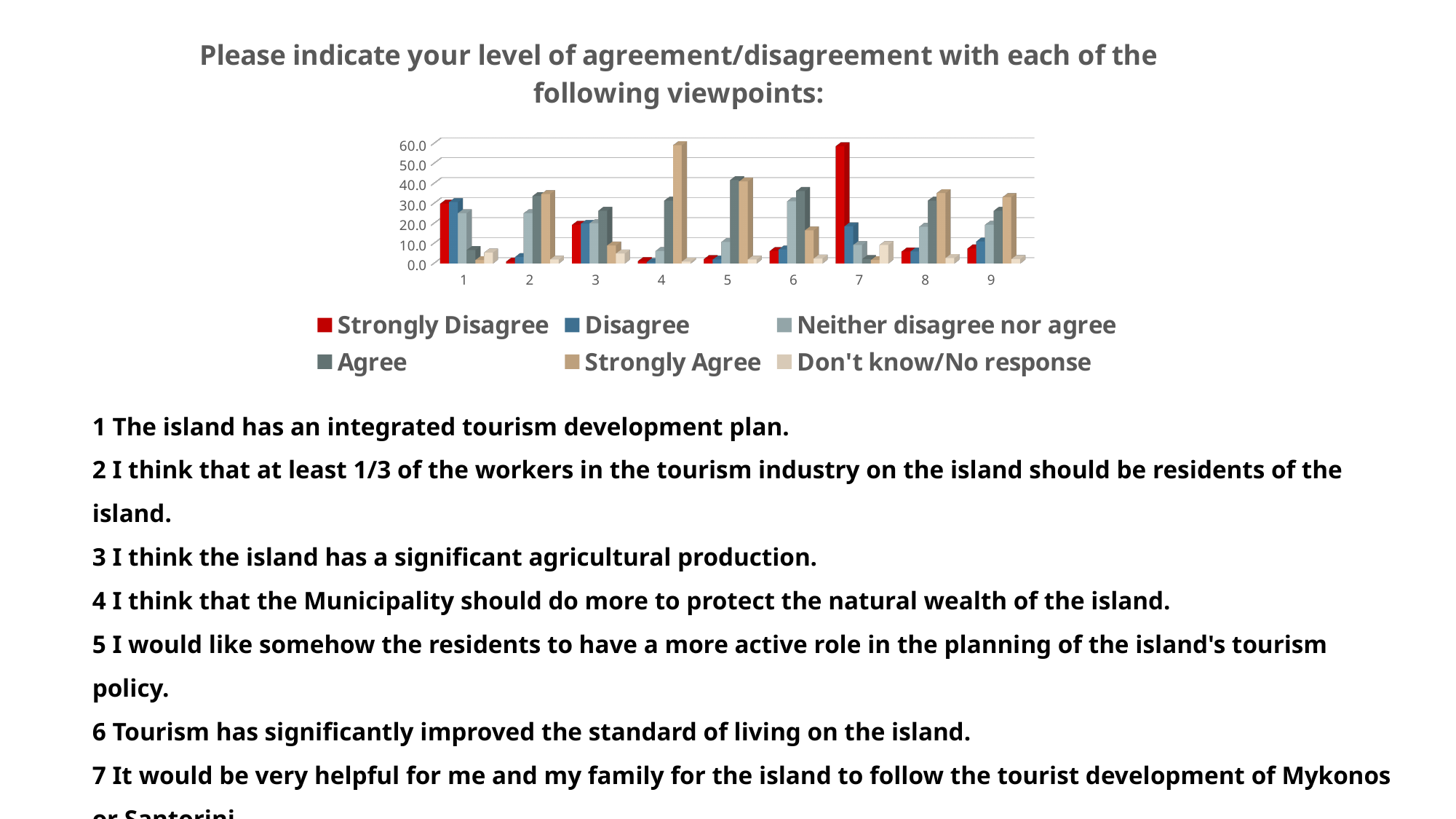
For category 2, which is larger: the Strongly Disagree value or the Strongly Agree value? Strongly Agree Which legend entry is shown in red? Strongly Disagree What kind of chart is shown on the slide? bar chart How many series does the chart's legend list? 6 Is the Strongly Agree value for category 4 greater or less than 50? greater Is the Agree value for category 1 greater or less than 10? less Is the Neither disagree nor agree value for category 6 greater or less than 20? greater For category 7, which is larger: the Strongly Disagree value or the Disagree value? Strongly Disagree For which category is the Strongly Disagree bar the highest? 7 For which category is the Strongly Agree bar the highest? 4 How many categories (viewpoints) are plotted along the x axis of the chart? 9